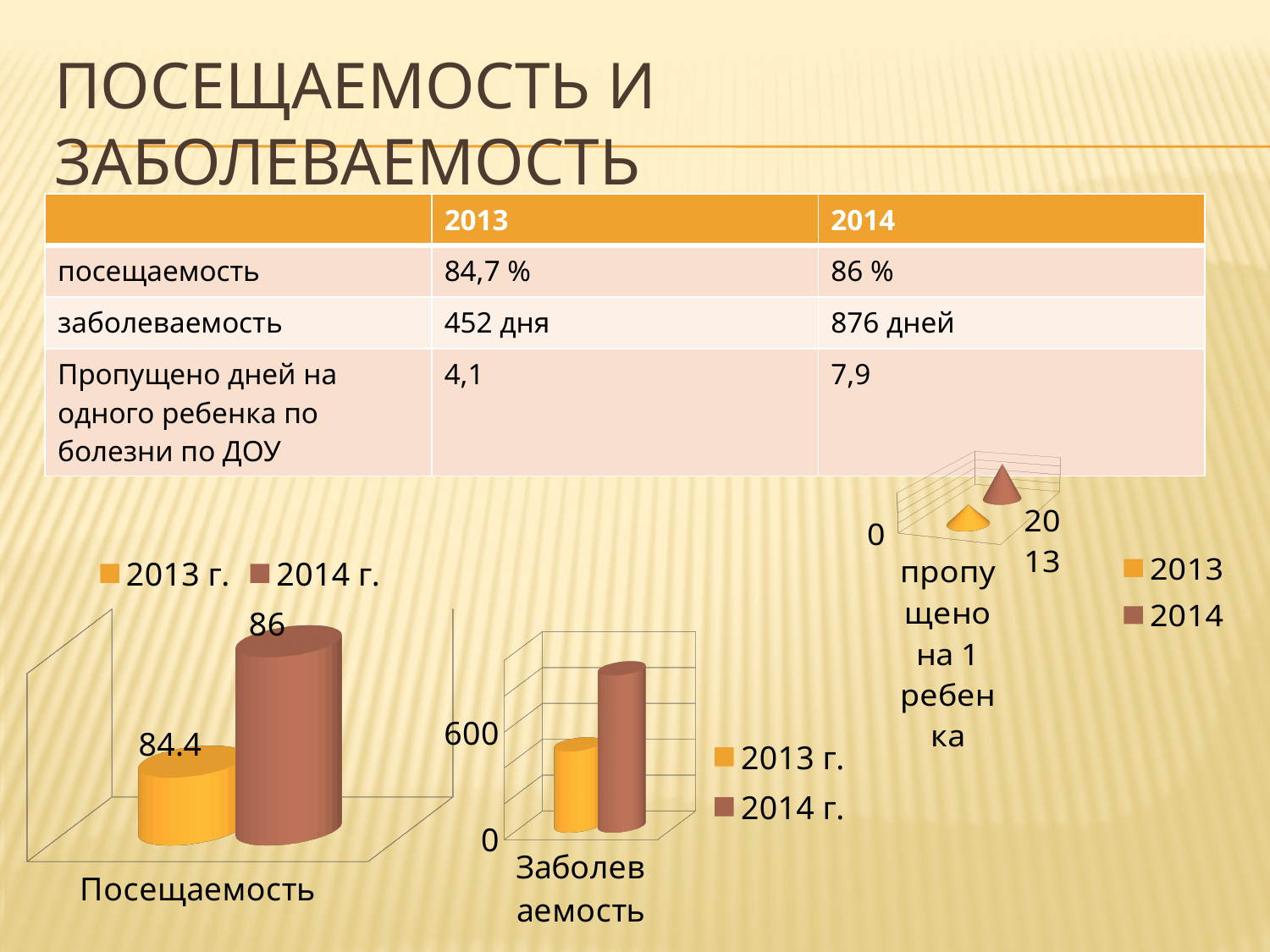
In the Посещаемость chart on the left, what is the value for 2014 г.? 86 In the Заболеваемость chart in the middle, is the value for 2014 г. greater or less than 600? greater In the Заболеваемость chart in the middle, what are the legend entries? 2013 г., 2014 г. In the Посещаемость chart on the left, which series has the higher value? 2014 г. In the Посещаемость chart on the left, what is the difference between the 2014 г. and 2013 г. values? 1.6 In the chart on the right (пропущено на 1 ребенка), how many series does the legend list? 2 In the Заболеваемость chart in the middle, which series has the larger value, 2013 г. or 2014 г.? 2014 г. In the Посещаемость chart on the left, how many series does the legend list? 2 What kind of chart is the Посещаемость chart on the left? bar chart In the chart on the right (пропущено на 1 ребенка), which series has the taller cone? 2014 In the Посещаемость chart on the left, what is the value for 2013 г.? 84.4 How many charts are shown on the slide? 3